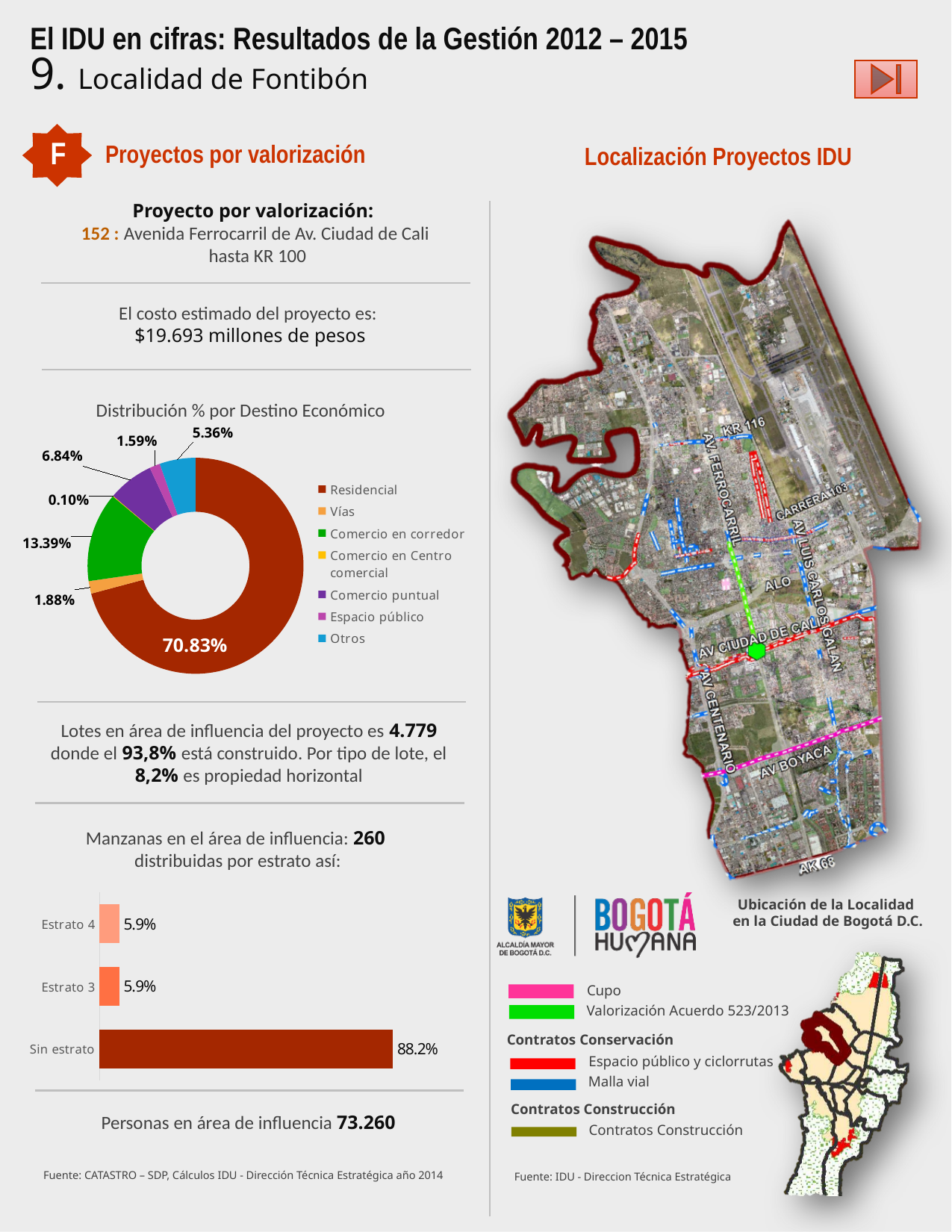
In the chart 'Distribución % por Destino Económico', what percentage is Otros? 5.36% In the bar chart of manzanas by estrato, what is the difference between Sin estrato and Estrato 4? 82.3% What kind of chart shows the manzanas distributed by estrato? Bar chart In the chart 'Distribución % por Destino Económico', how many categories does the legend list? 7 In the bar chart of manzanas by estrato, what percentage is Estrato 3? 5.9% In the bar chart of manzanas by estrato, what percentage is Sin estrato? 88.2% In the chart 'Distribución % por Destino Económico', what percentage is Residencial? 70.83% In the chart 'Distribución % por Destino Económico', what percentage is Comercio en corredor? 13.39% What kind of chart is 'Distribución % por Destino Económico'? Donut (pie) chart In the chart 'Distribución % por Destino Económico', which category has the largest share? Residencial In the chart 'Distribución % por Destino Económico', which category has the smallest share? Comercio en Centro comercial In the chart 'Distribución % por Destino Económico', which is larger, Comercio puntual or Otros? Comercio puntual